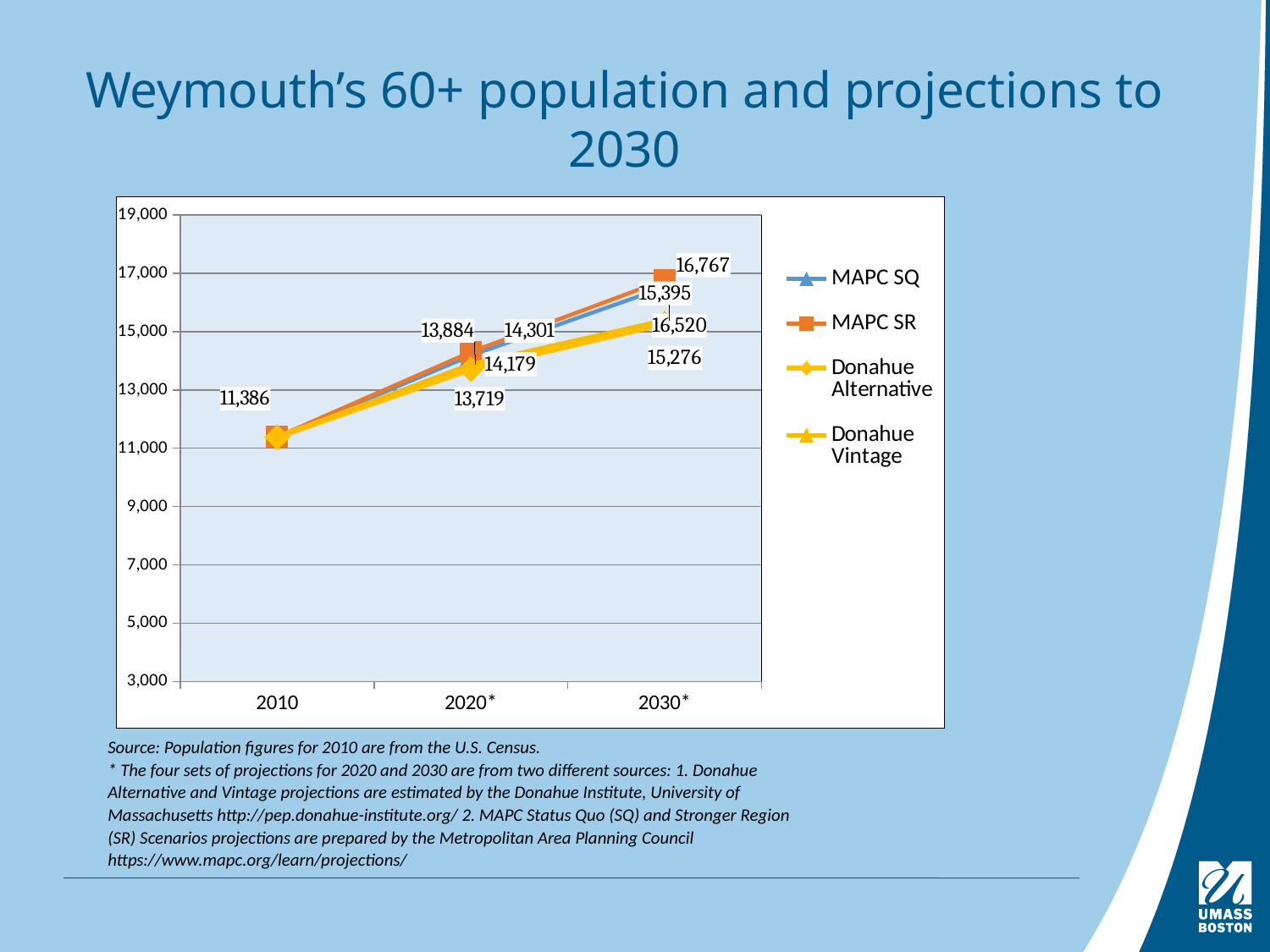
What kind of chart is shown on the slide? Line chart What is the difference between the highest (16,767) and lowest (15,276) values labelled for 2030*? 1,491 How many years are shown on the x axis? 3 Is the MAPC SR value for 2030* greater or less than 15,000? greater Which series has the highest value in 2030*? MAPC SR What is the 60+ population value shown for 2010? 11,386 Do the lines rise or fall from 2010 to 2030*? Rise Is the value for 2010 greater or less than 13,000? less What is the lowest value labelled for 2030*? 15,276 How many series does the legend list? 4 What is the highest value labelled for 2030*? 16,767 What is the title of the slide? Weymouth's 60+ population and projections to 2030